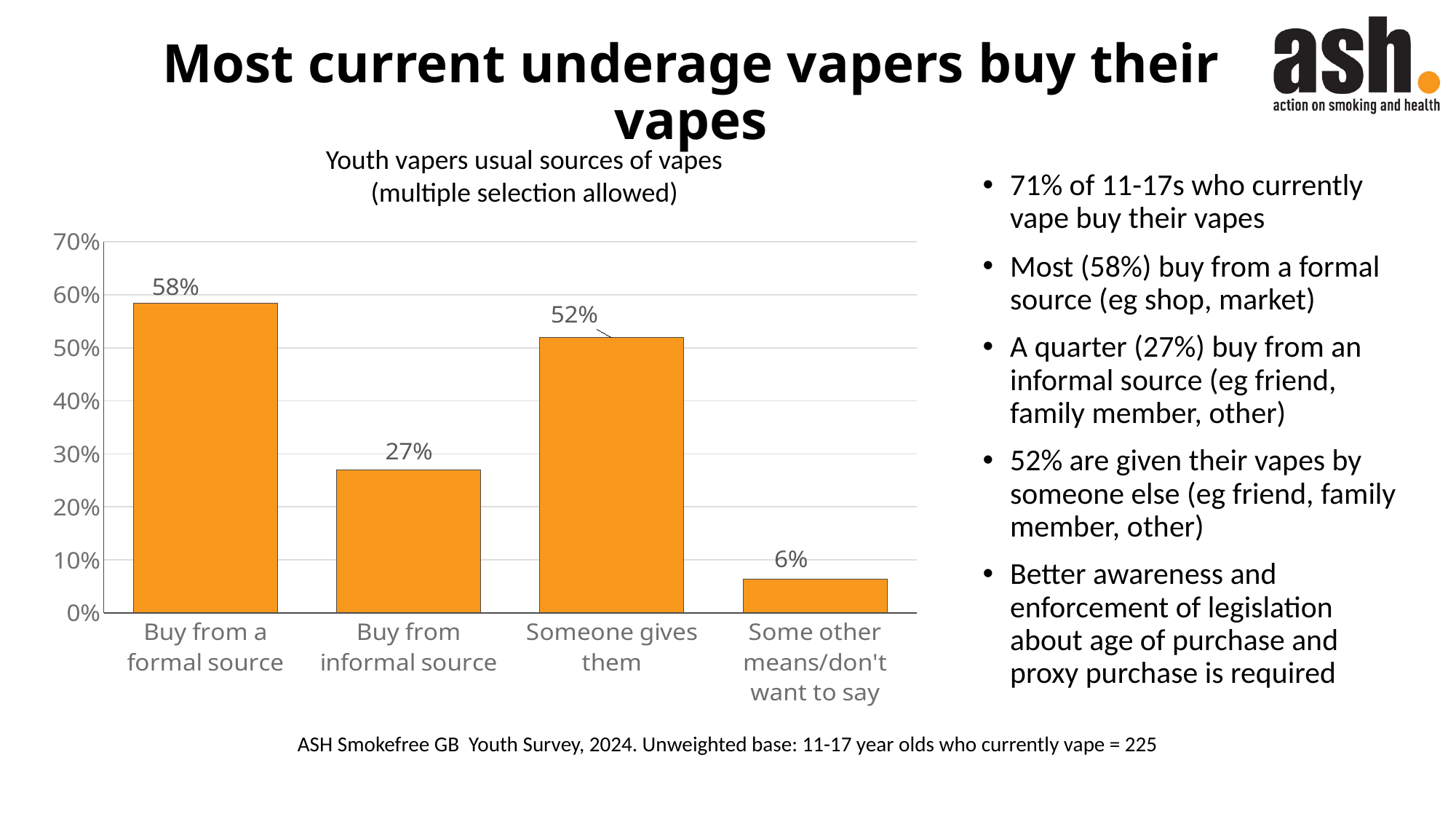
What percentage of youth vapers buy from a formal source? 58% Which source category has the lowest value? Some other means/don't want to say Which source category has the highest value? Buy from a formal source What is the title of the chart? Youth vapers usual sources of vapes (multiple selection allowed) What percentage of youth vapers buy from an informal source? 27% What is the difference between 'Buy from a formal source' and 'Buy from informal source'? 31 percentage points What percentage of youth vapers say someone gives them their vapes? 52% How many source categories are shown on the chart? 4 What kind of chart is shown on the slide? Bar chart Is the value for 'Buy from informal source' greater or less than 30%? less What is the value for 'Some other means/don't want to say'? 6% Which is larger: 'Buy from a formal source' or 'Someone gives them'? Buy from a formal source